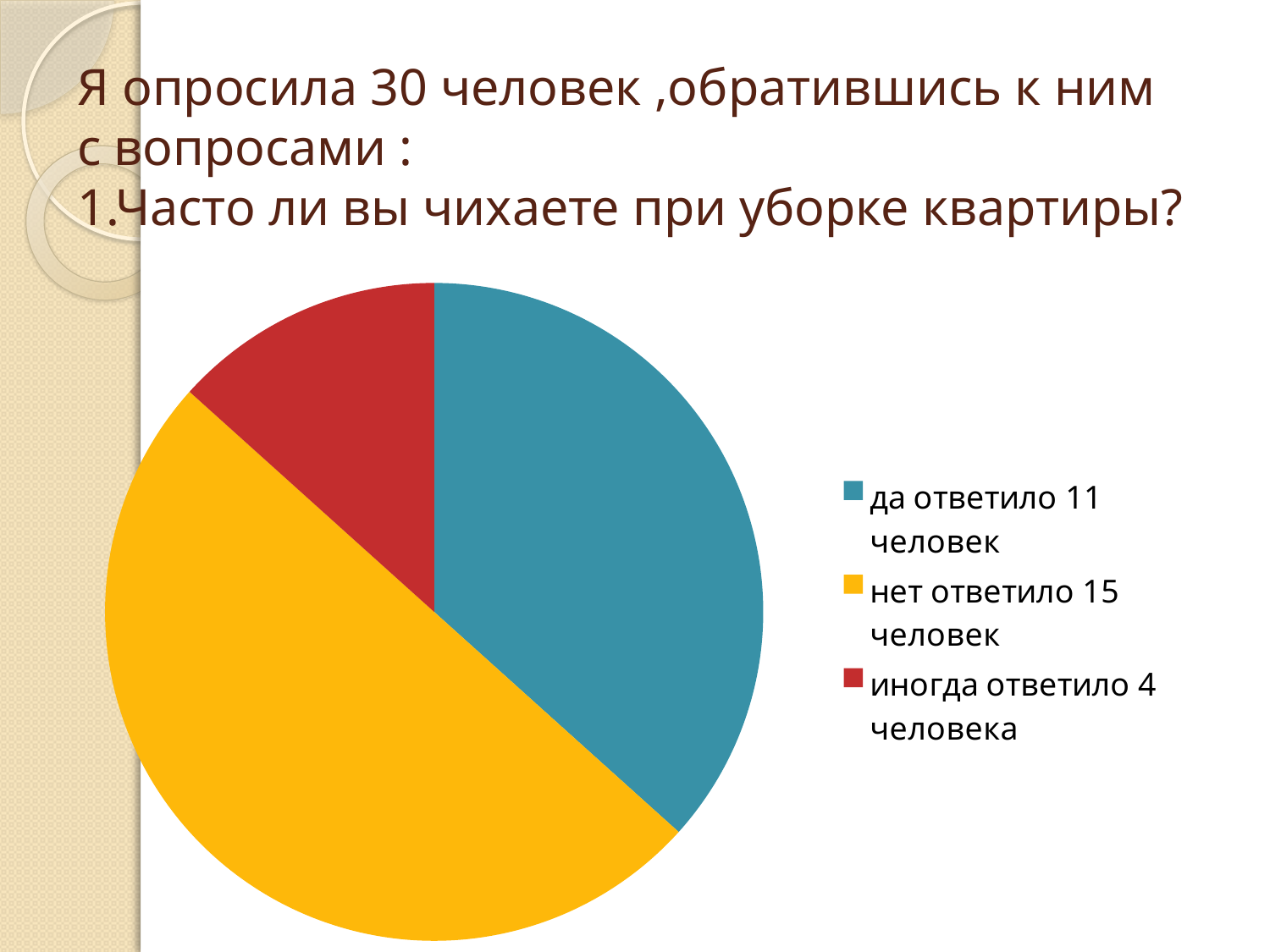
How many more people answered "нет" than "да"? 4 Which answer has the smallest slice of the pie chart? иногда How many entries does the legend of the pie chart list? 3 According to the legend, how many people answered "нет"? 15 According to the legend, how many people answered "да"? 11 What colour is the slice for "иногда" in the pie chart? red Which answer was given by more people, "да" or "иногда"? да According to the legend, how many people answered "иногда"? 4 Which answer has the largest slice of the pie chart? нет What share of the pie does the "нет" slice represent? 50% How many slices does the pie chart have? 3 What kind of chart is shown on the slide? pie chart